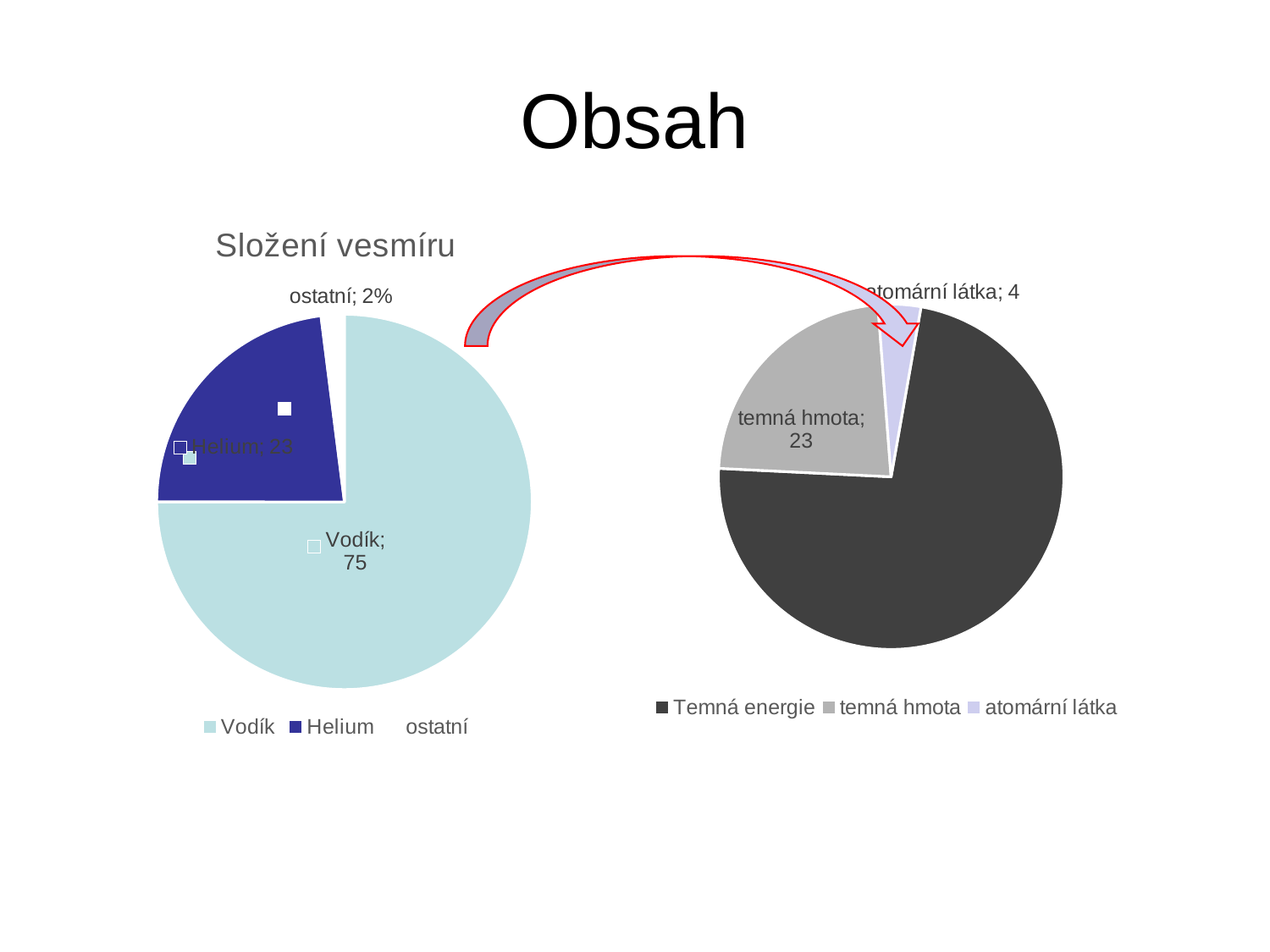
In the right chart, which category has the largest slice? Temná energie In the right chart, what is the value for atomární látka? 4 In the left chart titled 'Složení vesmíru', what is the difference between the values for Vodík and Helium? 52 In the left chart titled 'Složení vesmíru', which category has the smallest slice? ostatní In the right chart, which category has the smallest slice? atomární látka In the left chart titled 'Složení vesmíru', what is the value for Vodík? 75 In the left chart titled 'Složení vesmíru', what is the value for Helium? 23 What kind of chart is the left chart titled 'Složení vesmíru'? Pie chart How many slices does the right chart have? 3 In the left chart titled 'Složení vesmíru', what is the value shown for ostatní? 2% In the right chart, what is the value for temná hmota? 23 In the left chart titled 'Složení vesmíru', which category has the largest slice? Vodík